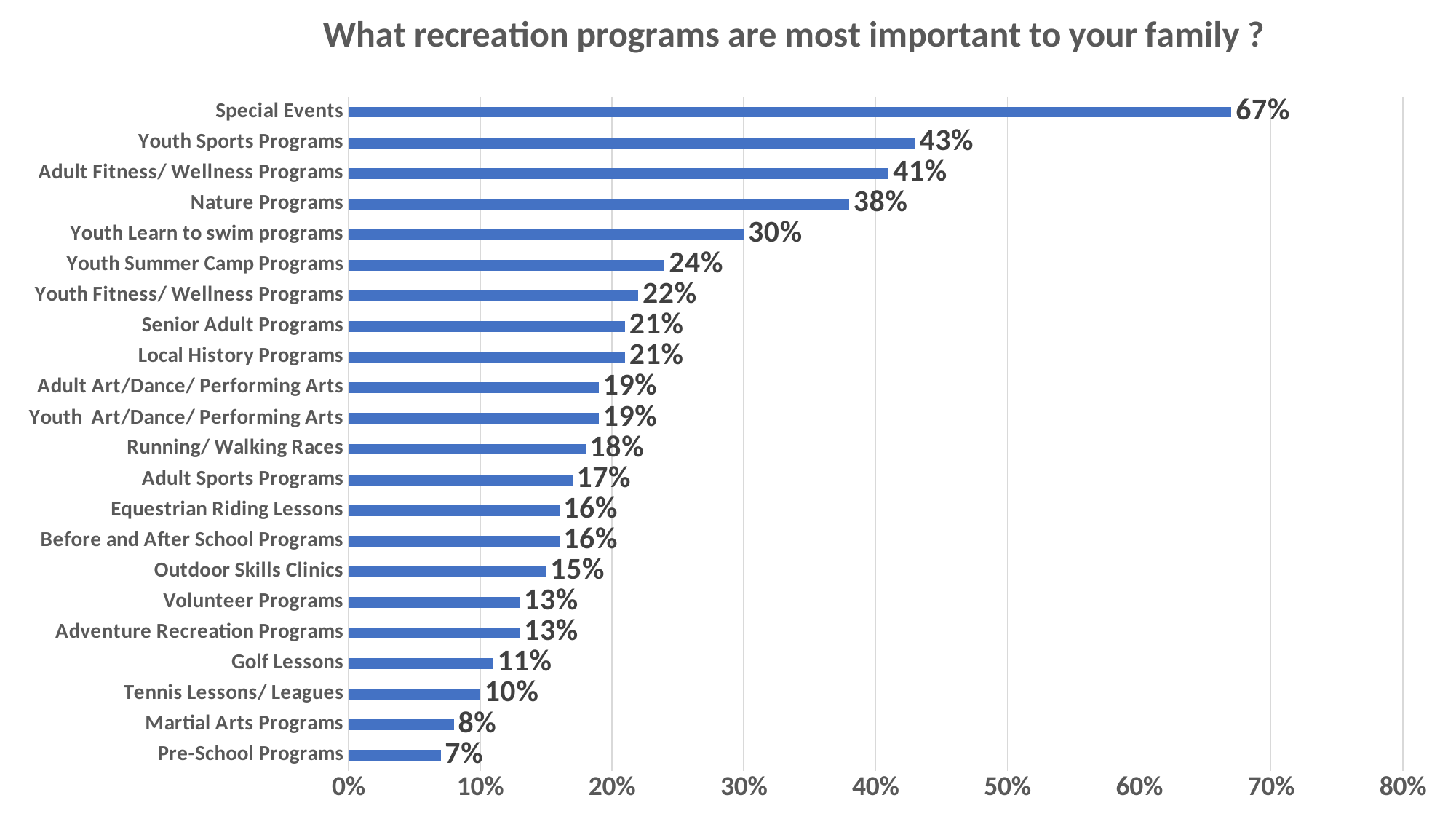
Which is larger, Golf Lessons or Martial Arts Programs? Golf Lessons How many programs are shown in the chart? 22 Which is larger, Youth Summer Camp Programs or Senior Adult Programs? Youth Summer Camp Programs Which program has the lowest value? Pre-School Programs What is the difference between Special Events and Pre-School Programs? 60% What kind of chart is shown on the slide? Bar chart What is the value for Special Events? 67% What is the value for Equestrian Riding Lessons? 16% What is the value for Nature Programs? 38% What is the difference between Youth Sports Programs and Youth Learn to swim programs? 13% What is the title of the chart? What recreation programs are most important to your family ? Which program has the highest value? Special Events